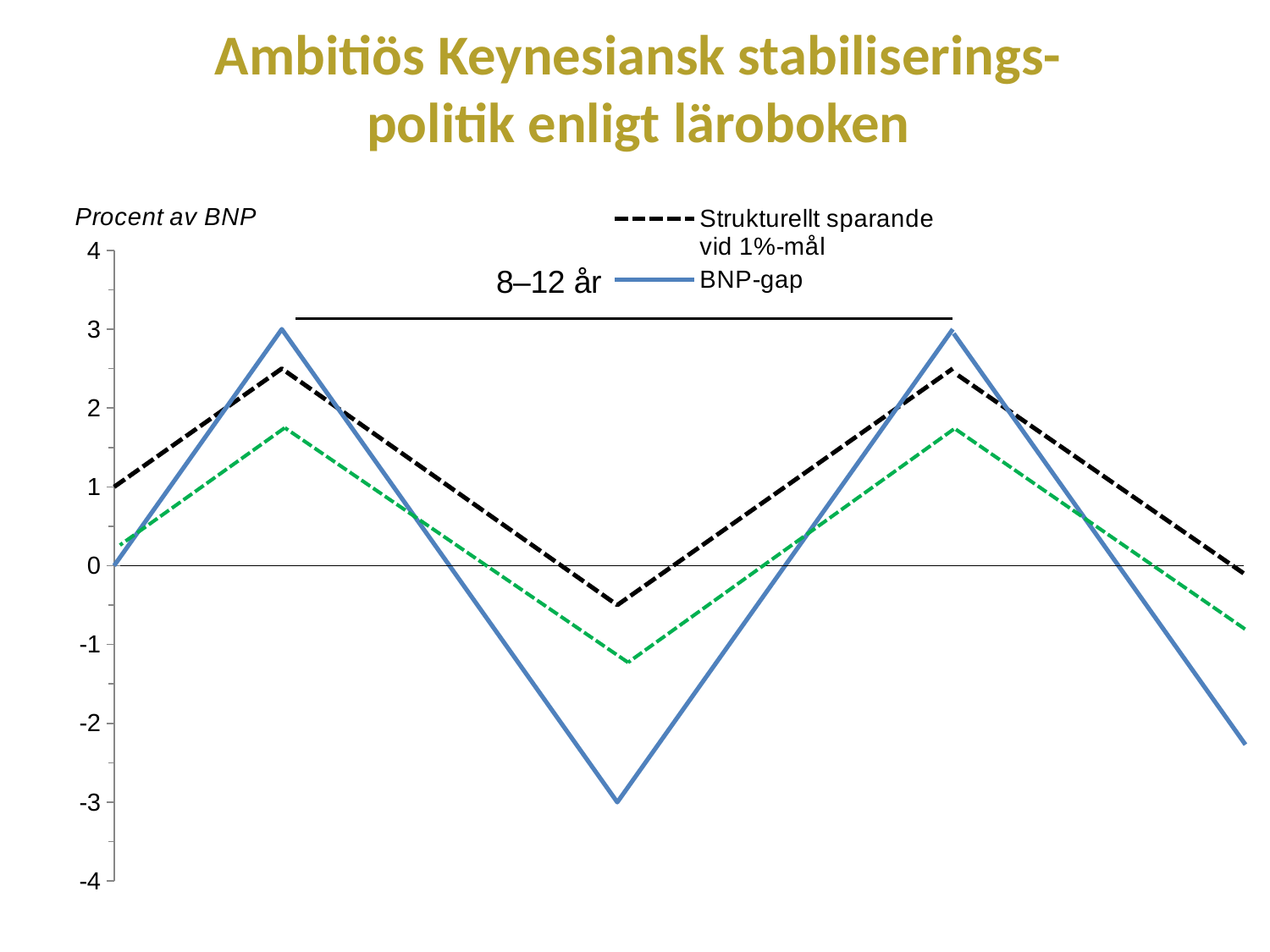
What time span is written above the horizontal bracket in the chart? 8–12 år What is the value at the top of the vertical axis? 4 What is the highest value reached by the BNP-gap line? 3 What is the difference between the highest and lowest values of the BNP-gap line? 6 What unit label is shown above the vertical axis? Procent av BNP Which line reaches a higher peak, BNP-gap or Strukturellt sparande vid 1%-mål? BNP-gap Which line reaches a lower trough, BNP-gap or Strukturellt sparande vid 1%-mål? BNP-gap Is the peak value of the Strukturellt sparande vid 1%-mål line greater or less than 3? less What is the lowest value reached by the BNP-gap line? -3 What kind of chart is shown on the slide? line chart Is the lowest value of the Strukturellt sparande vid 1%-mål line greater or less than -1? greater How many series does the legend list? 2